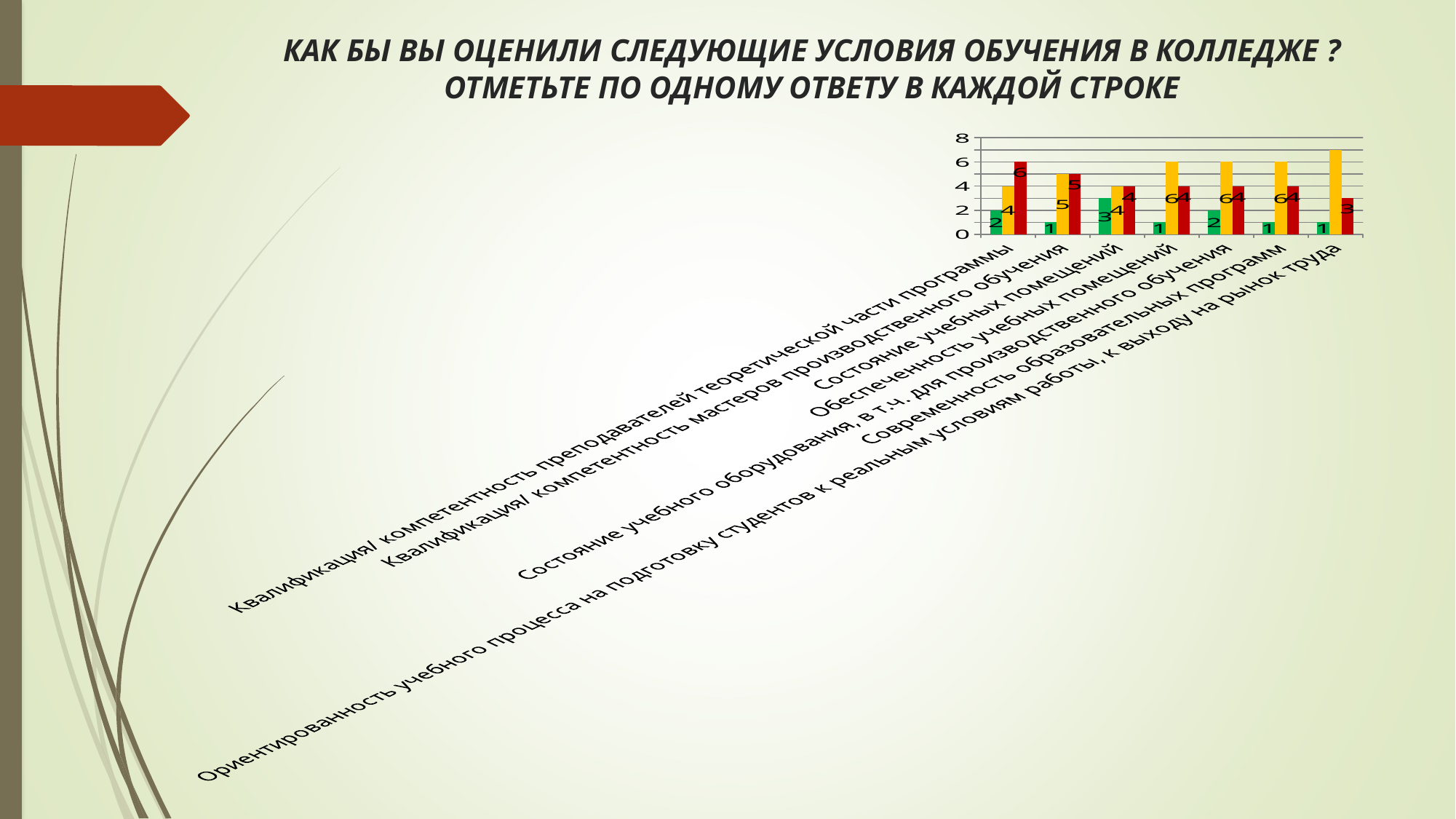
How many categories are shown on the x axis of the chart? 7 What is the value of the red bar for 'Ориентированность учебного процесса на подготовку студентов к реальным условиям работы, к выходу на рынок труда'? 3 What is the value of the red bar for 'Квалификация/ компетентность преподавателей теоретической части программы'? 6 Which category has the highest green bar? Состояние учебных помещений What kind of chart is shown on the slide? bar chart Which category has the lowest red bar? Ориентированность учебного процесса на подготовку студентов к реальным условиям работы, к выходу на рынок труда What is the value of the yellow bar for 'Современность образовательных программ'? 6 What is the value of the green bar for 'Состояние учебных помещений'? 3 Is the yellow bar for 'Ориентированность учебного процесса на подготовку студентов к реальным условиям работы, к выходу на рынок труда' greater or less than 6? greater Which is larger for 'Обеспеченность учебных помещений': the yellow bar or the red bar? the yellow bar What is the difference between the red bar and the green bar for 'Квалификация/ компетентность преподавателей теоретической части программы'? 4 What is the total of the three bars for 'Квалификация/ компетентность мастеров производственного обучения'? 11